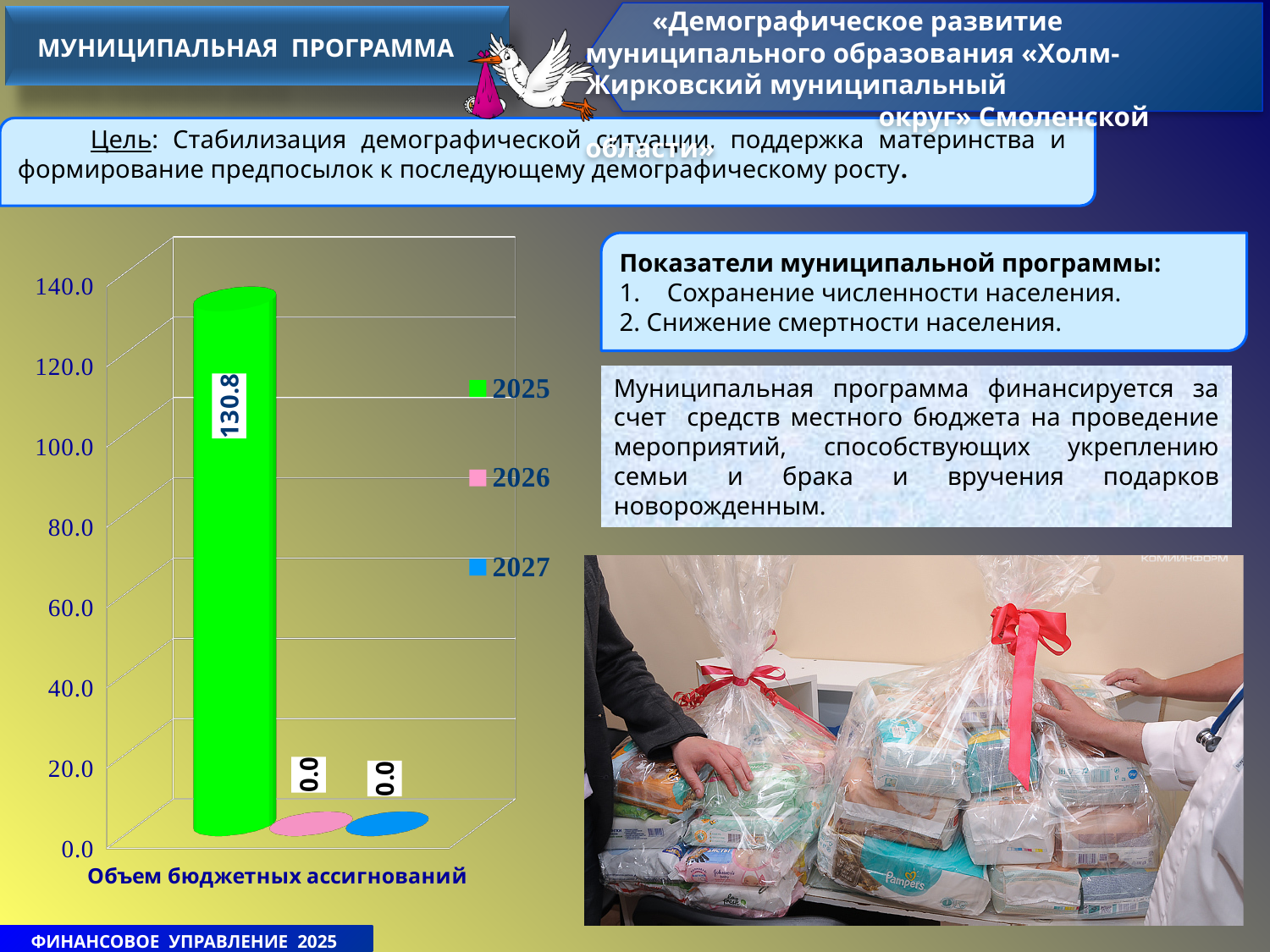
Is the value for 2025 greater or less than 120.0? greater What is the category label shown under the chart? Объем бюджетных ассигнований Which is larger, the value for 2025 or the value for 2027? 2025 What kind of chart is shown on the slide? bar chart What colour is the bar for 2025? green How many series does the legend list? 3 What is the difference between the values for 2025 and 2026? 130.8 What is the value for 2026 in the chart? 0.0 What is the highest tick value shown on the vertical axis? 140.0 Which year has the highest value in the chart? 2025 What is the value for 2027 in the chart? 0.0 What is the value for 2025 in the chart? 130.8